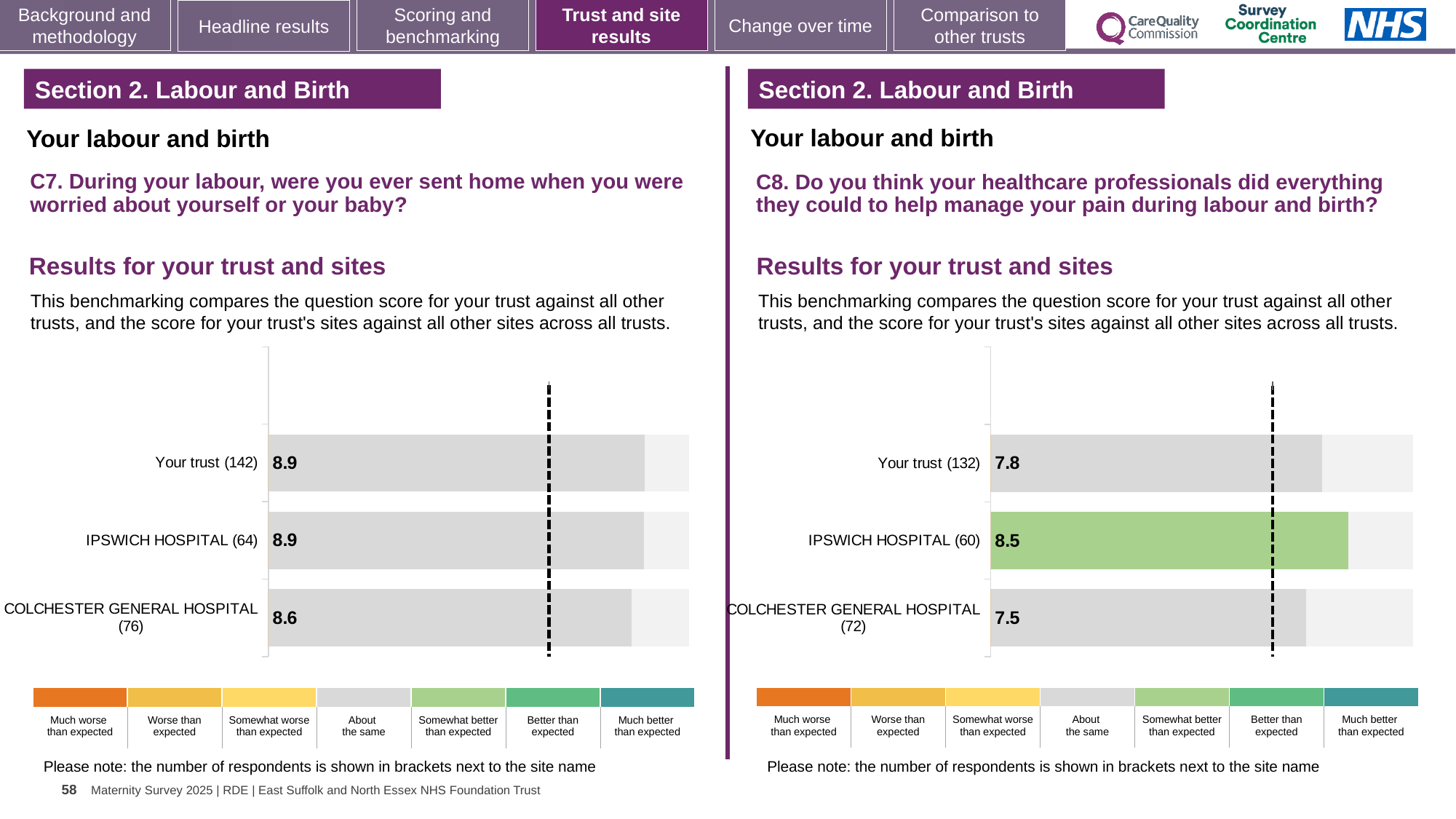
What type of chart is used for the C8 results on the right? Bar chart In the C8 chart on the right, which site or trust has the highest score? IPSWICH HOSPITAL In the C8 chart on the right, what is the score for Your trust? 7.8 In the C8 chart on the right, what is the score for IPSWICH HOSPITAL? 8.5 In the C8 chart on the right, which site or trust has the lowest score? COLCHESTER GENERAL HOSPITAL In the C8 chart on the right, which has the larger score, Your trust or IPSWICH HOSPITAL? IPSWICH HOSPITAL In the C7 chart on the left, what is the difference between the scores for IPSWICH HOSPITAL and COLCHESTER GENERAL HOSPITAL? 0.3 In the C8 chart on the right, what is the difference between the scores for IPSWICH HOSPITAL and COLCHESTER GENERAL HOSPITAL? 1.0 In the C7 chart on the left, what is the score for Your trust? 8.9 In the C7 chart on the left, which site has the lowest score? COLCHESTER GENERAL HOSPITAL How many bars are plotted in the C7 chart on the left? 3 In the C7 chart on the left, what is the score for COLCHESTER GENERAL HOSPITAL? 8.6